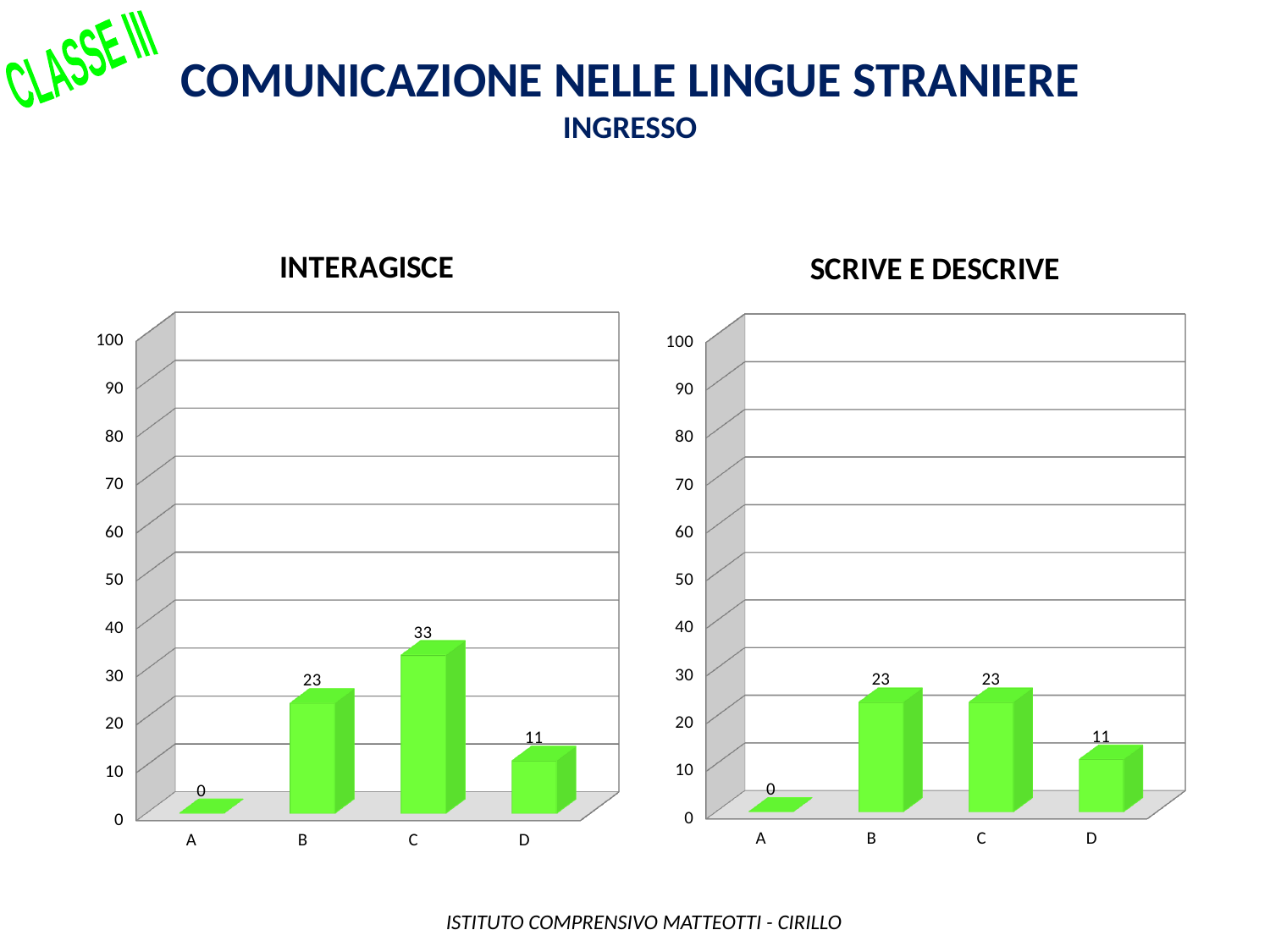
In the SCRIVE E DESCRIVE chart, what is the difference between the values for B and D? 12 In the SCRIVE E DESCRIVE chart, what is the value for category A? 0 How many categories are shown in the SCRIVE E DESCRIVE chart? 4 In the SCRIVE E DESCRIVE chart, which category has the lowest value? A In the INTERAGISCE chart, what is the value for category B? 23 In the INTERAGISCE chart, which is larger, the value for B or the value for D? B In the SCRIVE E DESCRIVE chart, what is the value for category D? 11 In the INTERAGISCE chart, which category has the highest value? C In the INTERAGISCE chart, what is the difference between the values for C and D? 22 In the INTERAGISCE chart, which category has the lowest value? A In the INTERAGISCE chart, what is the value for category C? 33 What kind of chart is the INTERAGISCE chart? Bar chart